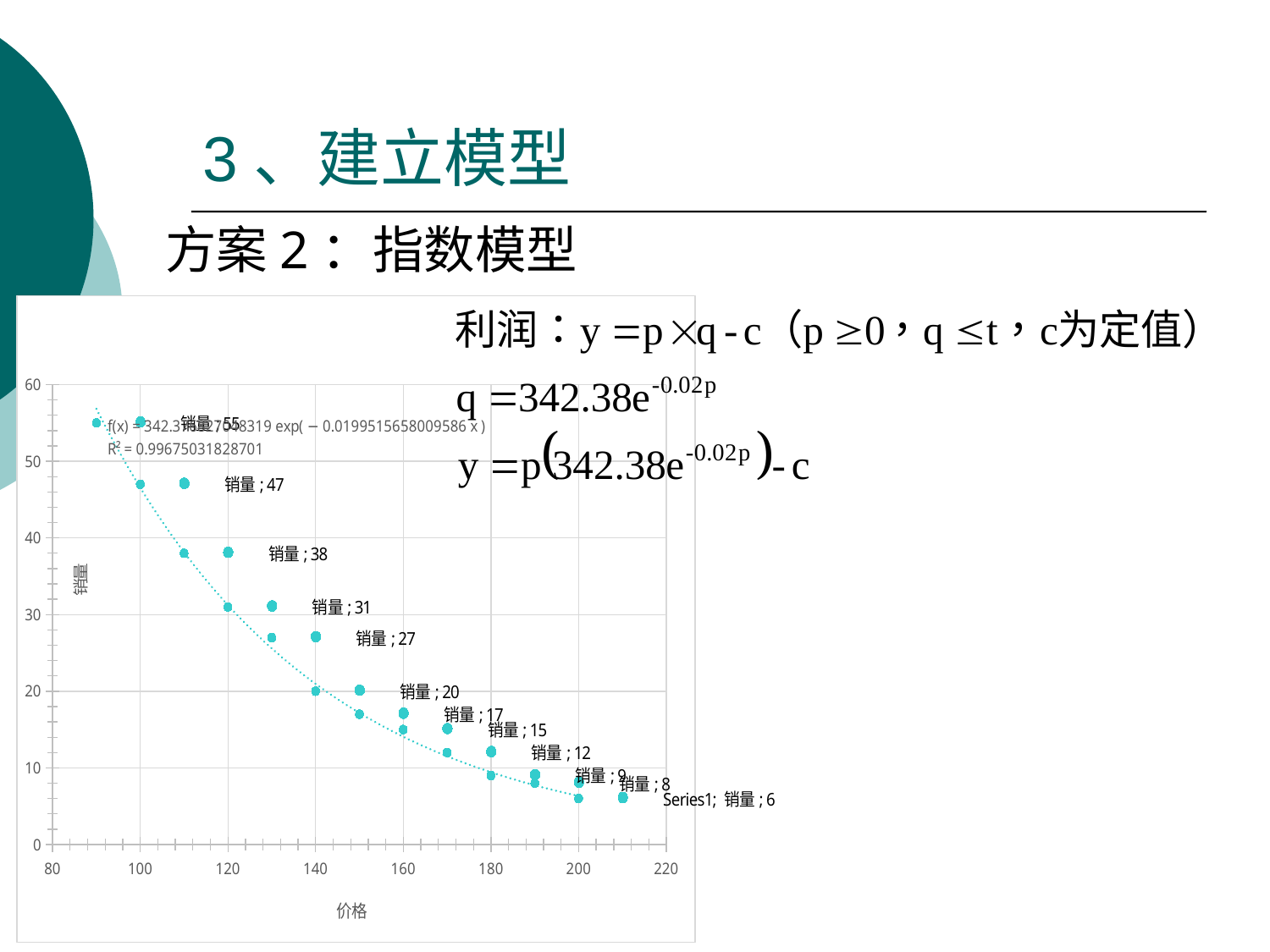
How many 销量 data labels are shown on the chart? 12 Do the 销量 values rise or fall as 价格 increases along the x axis? fall What is the title of the x axis? 价格 What kind of chart is shown on the slide? scatter chart Is the 销量 value at 价格 200 greater or less than 10? less What is the difference between the two highest labelled 销量 values, 55 and 47? 8 What is the difference between the labelled 销量 values 38 and 31? 7 What is the lowest 销量 value labelled on the chart? 6 Is the 销量 value at 价格 90 greater or less than 50? greater What is the highest 销量 value labelled on the chart? 55 What is the title of the y axis? 销量 Which is larger, the 销量 value at 价格 90 or the 销量 value at 价格 200? 价格 90